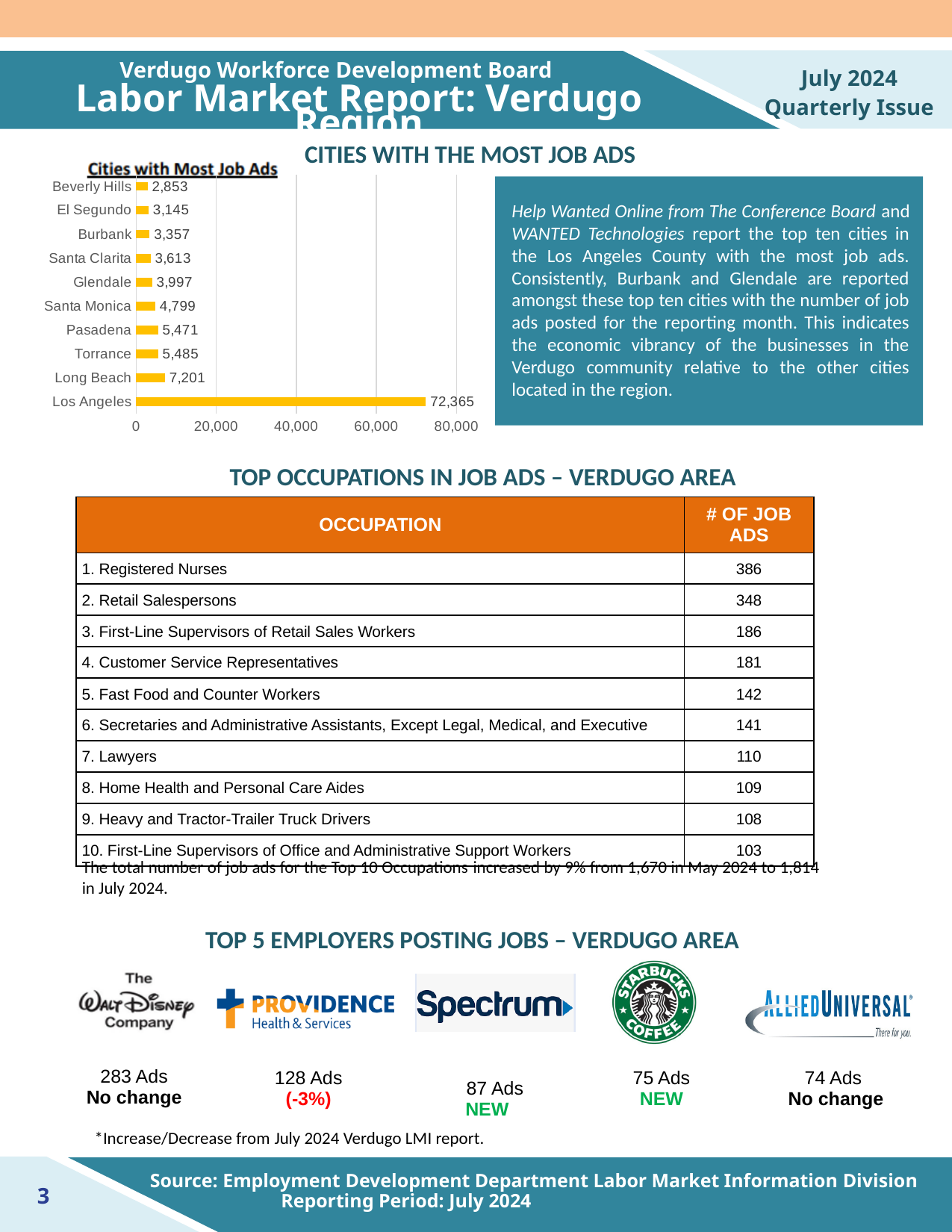
How many cities are shown in the "Cities with Most Job Ads" chart? 10 How many job ads does Glendale have in the "Cities with Most Job Ads" chart? 3,997 In the "Cities with Most Job Ads" chart, what is the difference between Long Beach and Santa Monica? 2,402 What is the value for Los Angeles in the "Cities with Most Job Ads" chart? 72,365 How many job ads does Burbank have in the "Cities with Most Job Ads" chart? 3,357 In the "Cities with Most Job Ads" chart, how many more job ads does Glendale have than Burbank? 640 Which city has the most job ads in the "Cities with Most Job Ads" chart? Los Angeles What is the value for Long Beach in the "Cities with Most Job Ads" chart? 7,201 In the "Cities with Most Job Ads" chart, is the value for Los Angeles greater or less than 60,000? greater What kind of chart is the "Cities with Most Job Ads" chart? bar chart In the "Cities with Most Job Ads" chart, which has more job ads, Santa Monica or Santa Clarita? Santa Monica Which city has the fewest job ads in the "Cities with Most Job Ads" chart? Beverly Hills